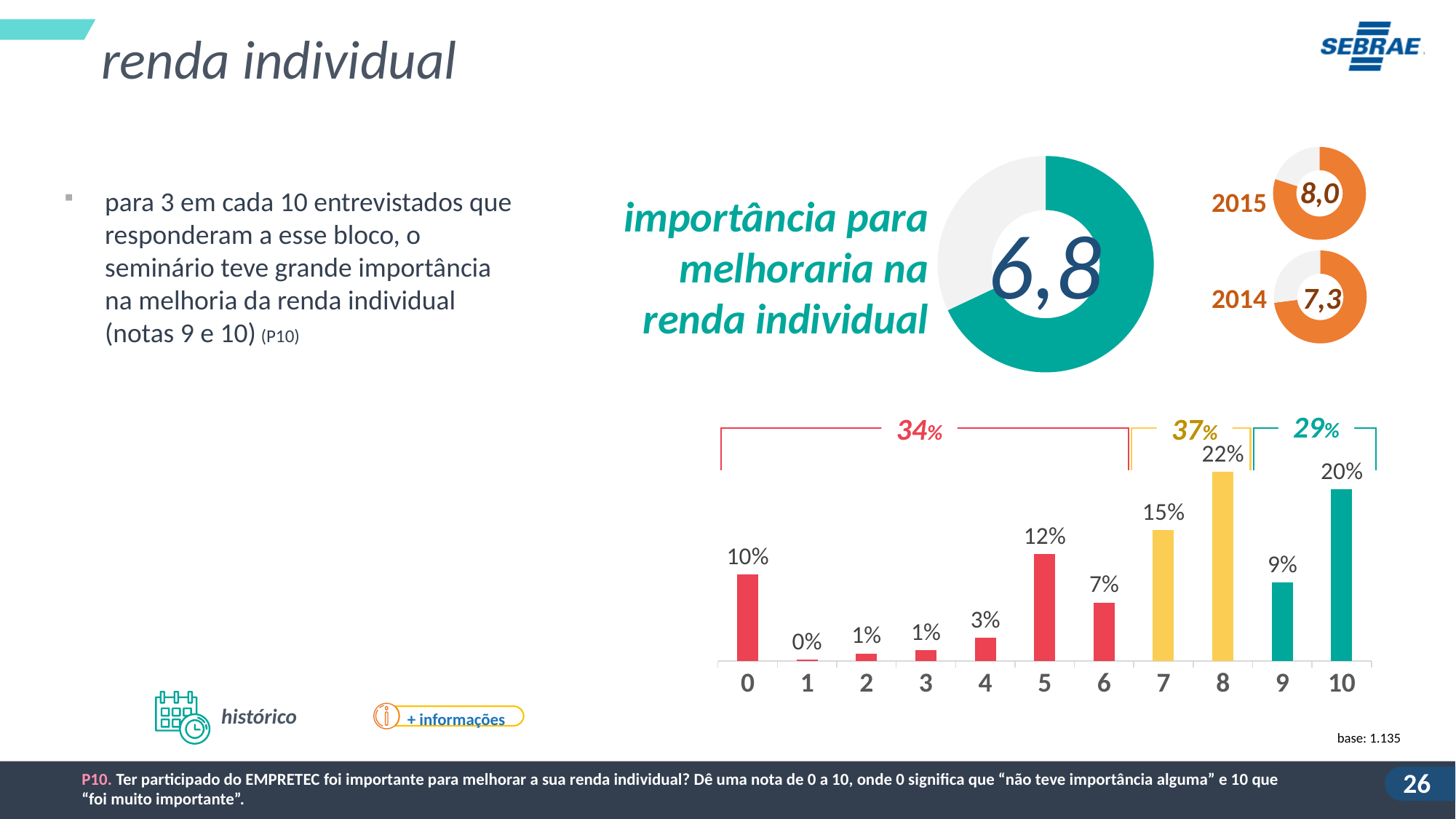
In the bar chart, what percentage of respondents gave a score of 10? 20% What value is shown in the centre of the large donut chart for 'importância para melhoraria na renda individual'? 6,8 In the bar chart, what is the difference between the percentage for score 8 and the percentage for score 10? 2% In the bar chart, what percentage of respondents gave a score of 0? 10% In the bar chart, which has a larger percentage: score 5 or score 6? 5 In the bar chart, what combined percentage is shown above the bracket covering scores 7 and 8? 37% What type of chart is used to show the distribution of scores from 0 to 10? bar chart In the bar chart, what percentage of respondents gave a score of 8? 22% How many score categories are shown on the x axis of the bar chart? 11 In the small donut charts on the right, what value is shown for 2015? 8,0 In the bar chart, which score has the highest percentage of respondents? 8 In the bar chart, which score has the lowest percentage of respondents? 1